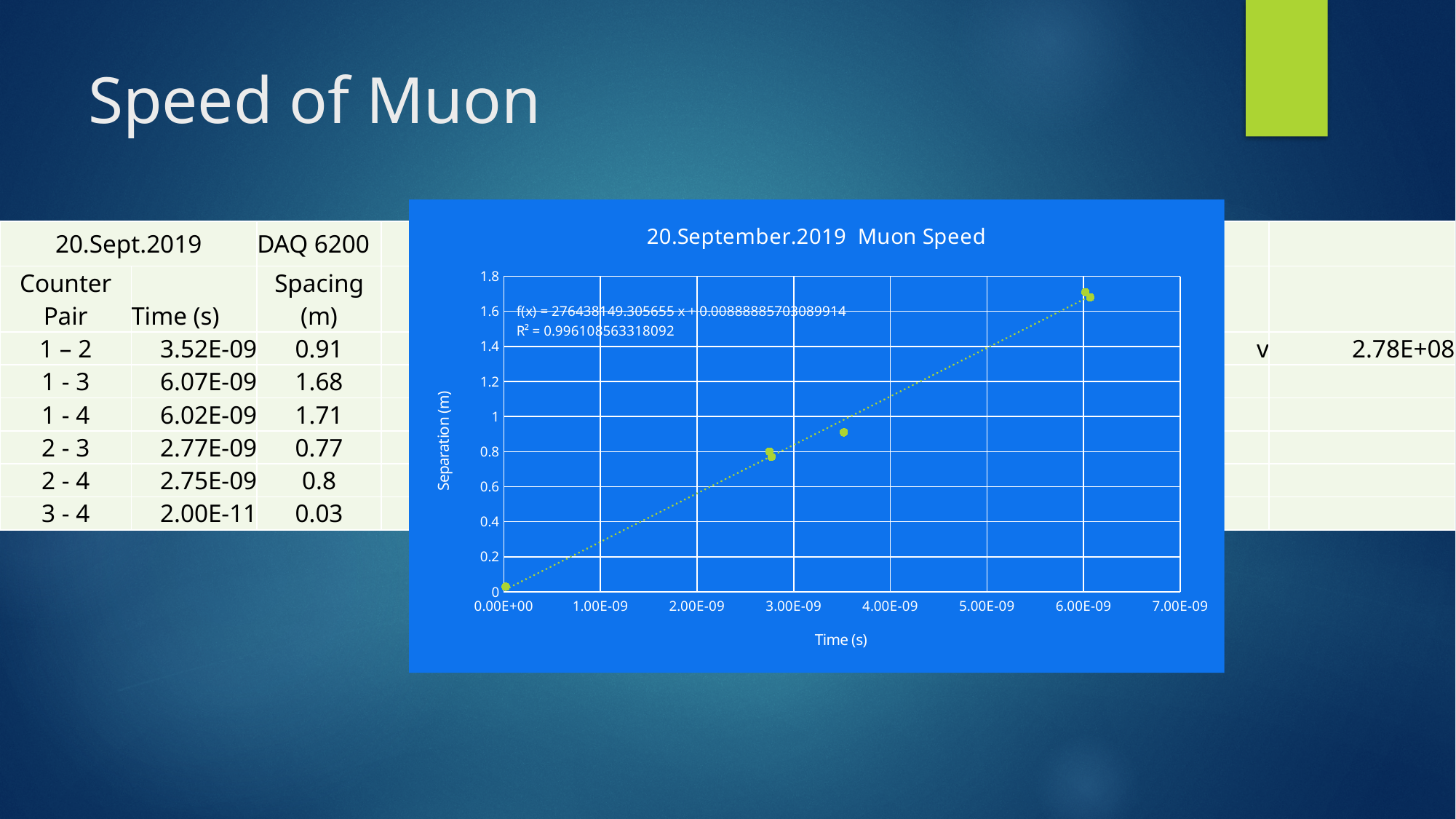
Which has the larger separation: the point near 6.00E-09 s or the point near 3.5E-09 s? the point near 6.00E-09 s Do the plotted separation values rise or fall as time increases along the x axis? rise Are the separation values for the points near 6.00E-09 s greater or less than 1.6? greater What is the highest tick value shown on the chart's horizontal axis? 7.00E-09 Is the separation value for the point near 0.00E+00 s greater or less than 0.2? less What R² value is printed on the chart for the trendline? 0.996108563318092 What is the label of the chart's vertical axis? Separation (m) How many data points are plotted in the chart? 6 Is the separation value for the point at about 3.5E-09 s greater or less than 0.8? greater What is the highest tick value shown on the chart's vertical axis? 1.8 What kind of chart is shown on the slide? scatter chart What is the title of the chart? 20.September.2019 Muon Speed